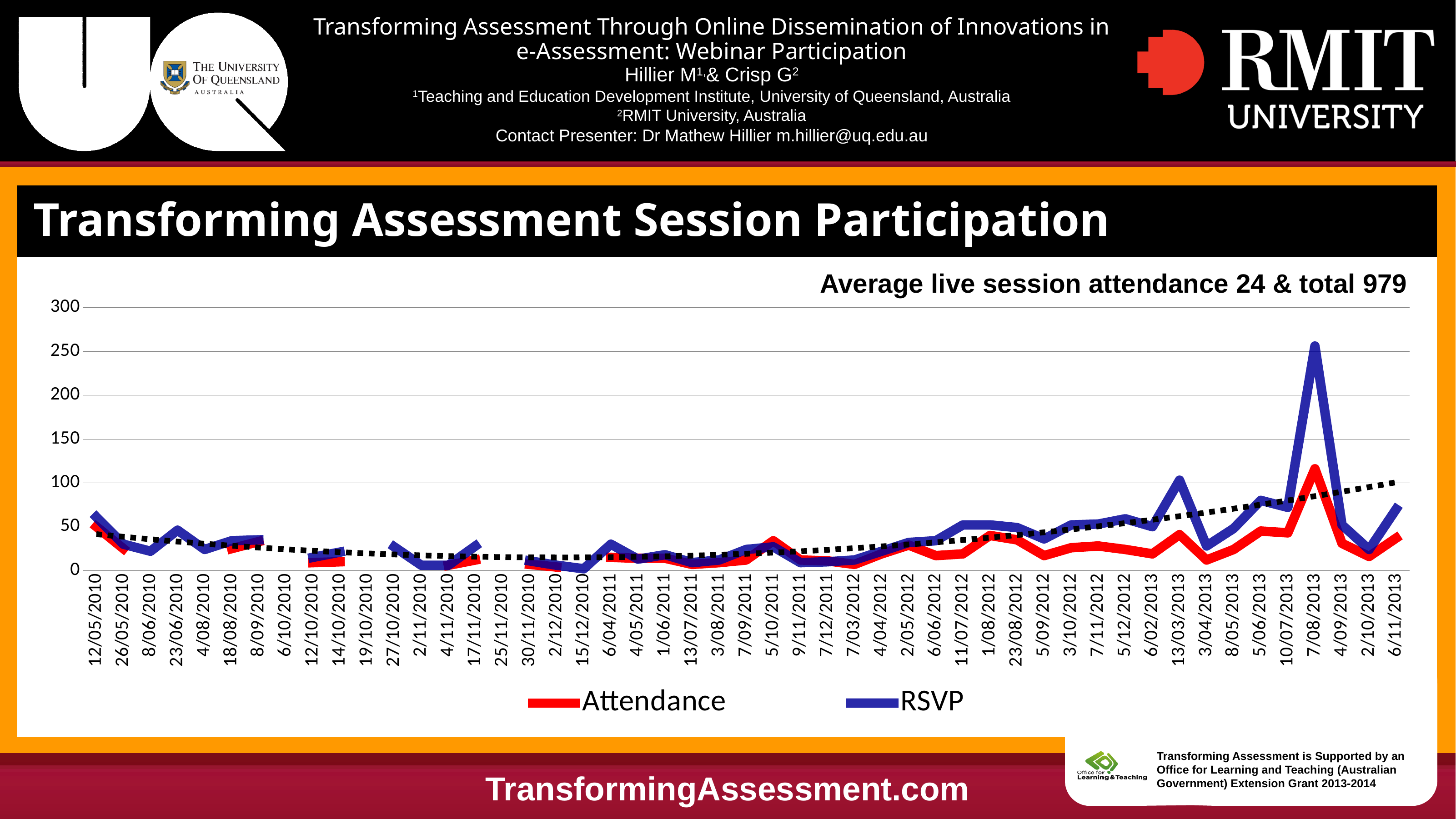
Is the RSVP value for 15/12/2010 greater or less than 50? less How many series does the chart legend list? 2 On 7/08/2013, which is larger: the RSVP value or the Attendance value? RSVP Is the Attendance value for 12/05/2010 greater or less than 100? less Which series is drawn in red in the chart? Attendance Is the Attendance value for 7/08/2013 greater or less than 100? greater Does the dotted trend line rise or fall from left to right across the chart? rise On which date does the RSVP series reach its highest value? 7/08/2013 What kind of chart is shown on the slide? line chart According to the text above the chart, what is the average live session attendance? 24 On which date does the Attendance series reach its highest value? 7/08/2013